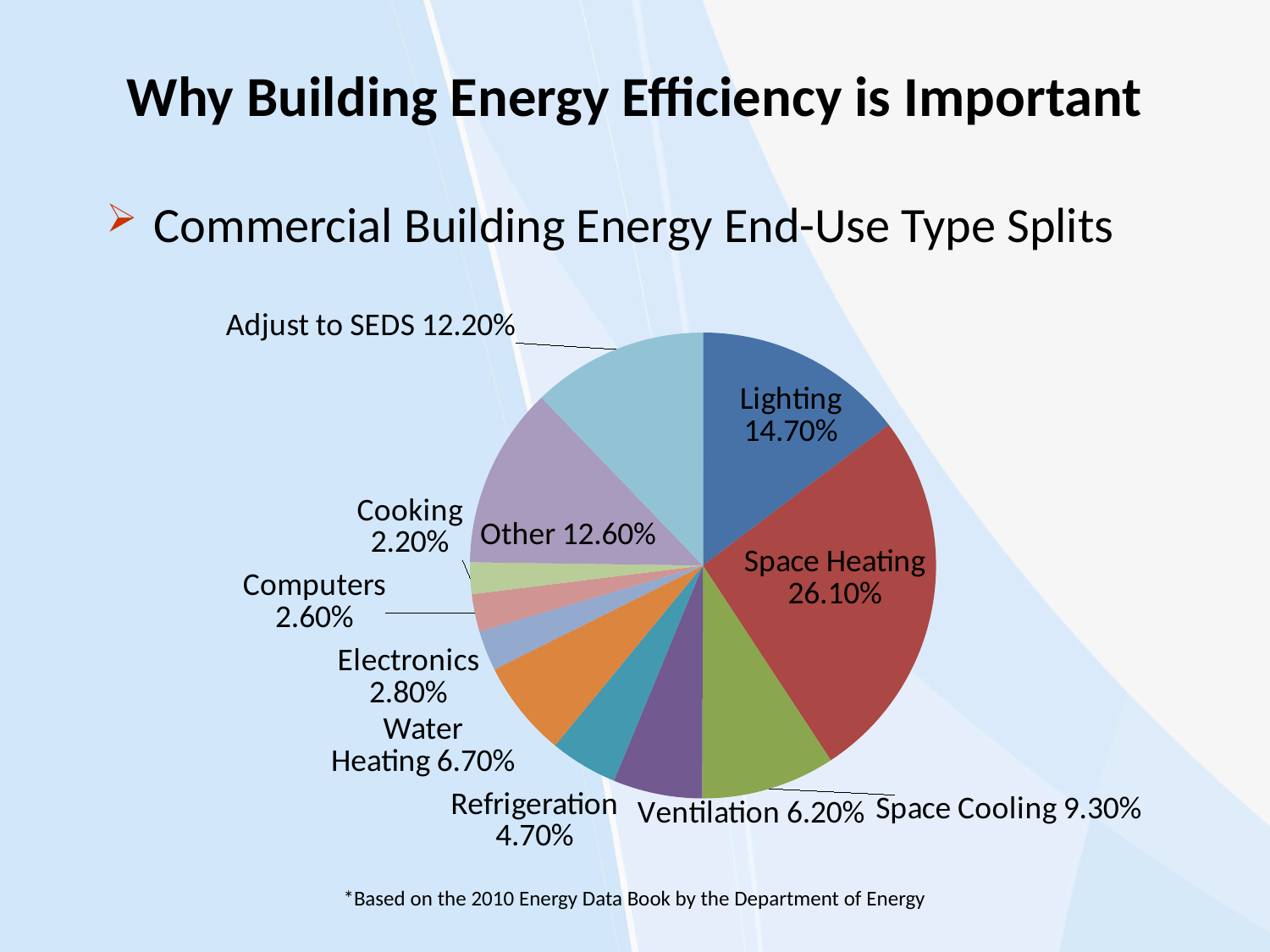
What is the value shown for Lighting? 14.70% According to the footnote, what source is the chart based on? the 2010 Energy Data Book by the Department of Energy What kind of chart is shown on the slide? pie chart What is the value shown for Water Heating? 6.70% What is the difference between the Space Heating and Lighting shares? 11.40% What is the value shown for Adjust to SEDS? 12.20% Which end-use type has the largest slice of the pie? Space Heating Which end-use type has the smallest slice of the pie? Cooking How many slices does the pie chart have? 11 What is the difference between the Other and Adjust to SEDS shares? 0.40% Which is larger, the share for Space Cooling or the share for Ventilation? Space Cooling What share of commercial building energy end-use is Space Heating? 26.10%